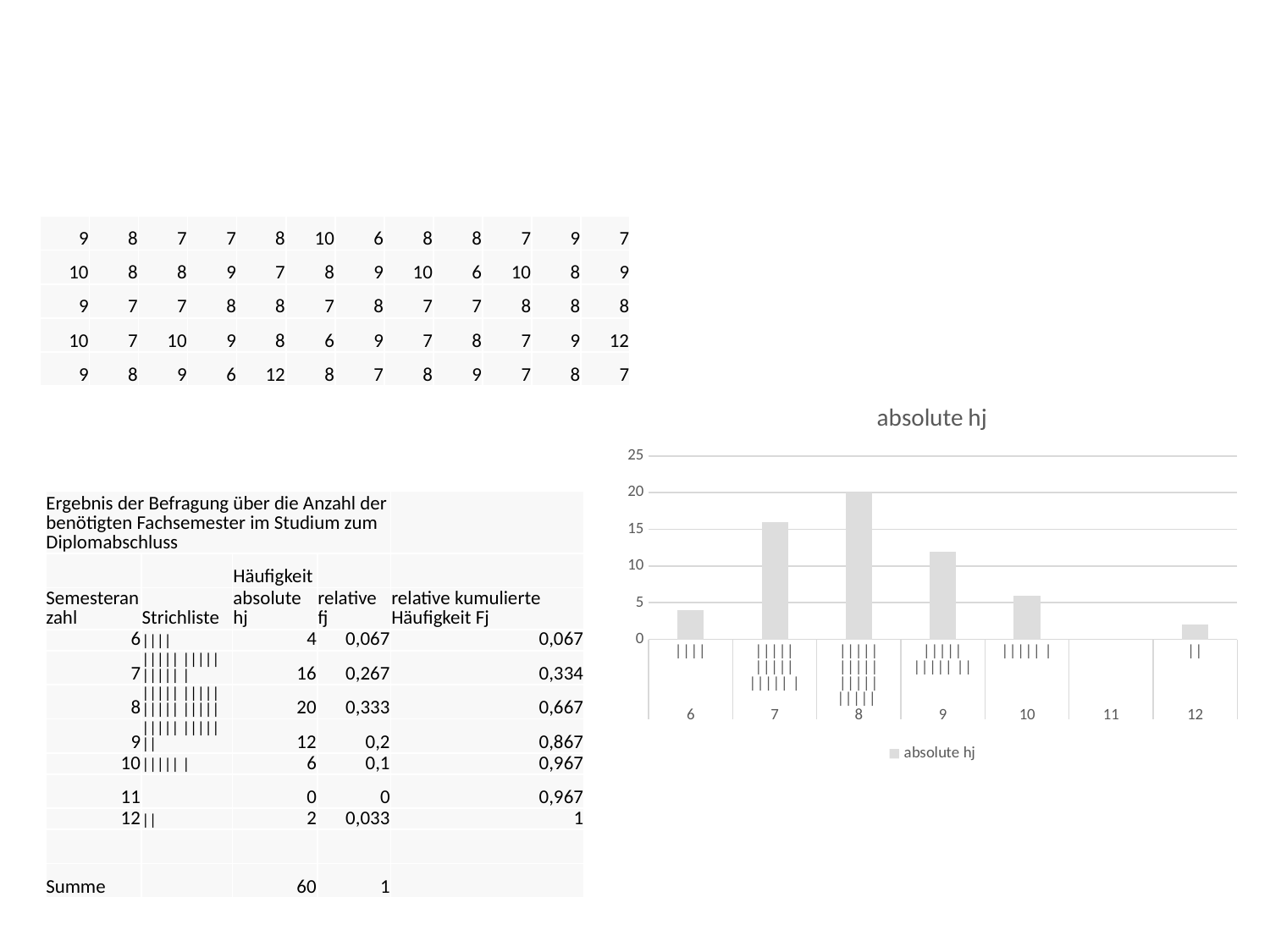
What kind of chart is shown on the slide? bar chart Is the value for category 12 greater or less than 5? less What is the value of the bar for category 8? 20 Is the value for category 7 greater or less than 15? greater What is the value of the bar for category 11? 0 Which category has the highest bar in the chart? 8 How many categories are shown on the x axis of the chart? 7 What is the title of the chart? absolute hj Which bar is taller, category 7 or category 9? 7 Is the value for category 9 greater or less than 10? greater How many series does the chart legend list? 1 Which category has the lowest bar in the chart? 11